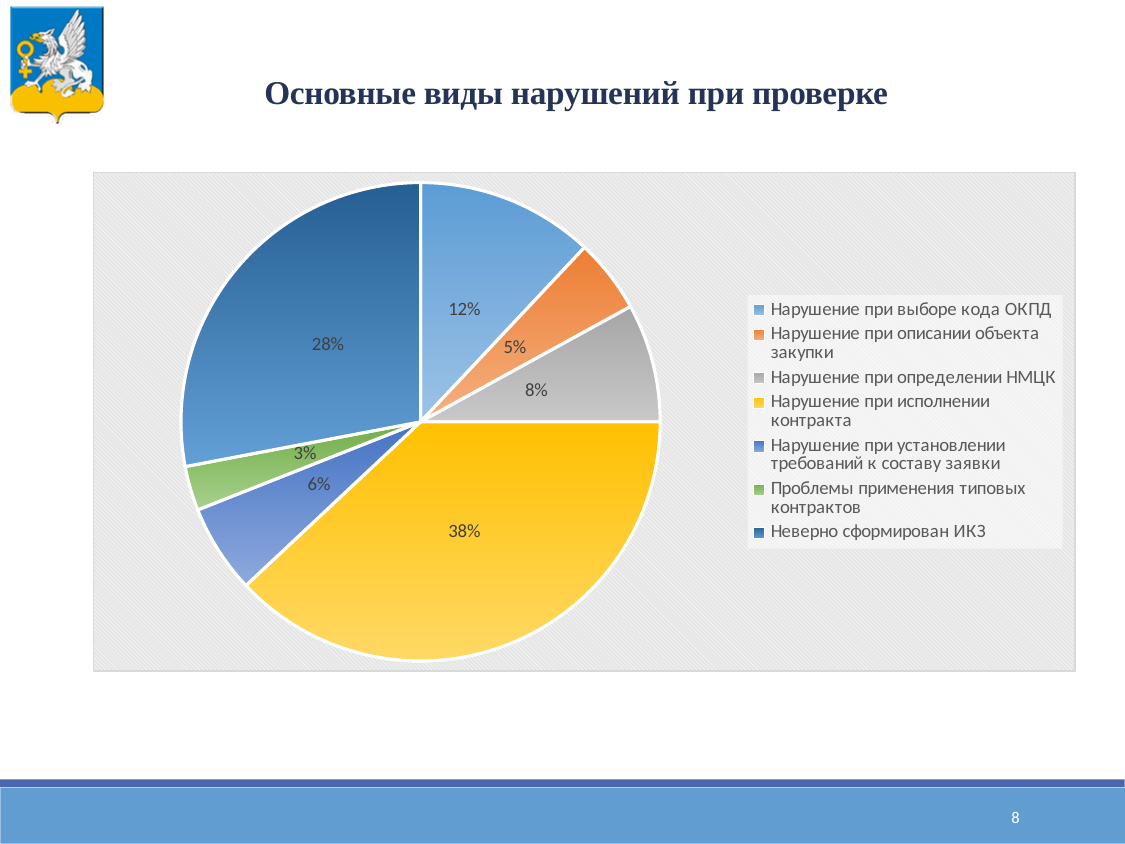
What is the title of the slide containing the chart? Основные виды нарушений при проверке Which category has the largest share of the pie? Нарушение при исполнении контракта Which category has the smallest share of the pie? Проблемы применения типовых контрактов What is the value for "Нарушение при определении НМЦК"? 8% What is the difference between the shares for "Нарушение при исполнении контракта" and "Неверно сформирован ИКЗ"? 10% What share of the pie is labelled "Неверно сформирован ИКЗ"? 28% What share of the pie is labelled "Нарушение при исполнении контракта"? 38% How many categories does the pie chart have? 7 What kind of chart is shown on the slide? Pie chart Which is larger: the share for "Нарушение при описании объекта закупки" or the share for "Нарушение при установлении требований к составу заявки"? Нарушение при установлении требований к составу заявки What is the value for "Нарушение при выборе кода ОКПД"? 12% What is the value for "Проблемы применения типовых контрактов"? 3%